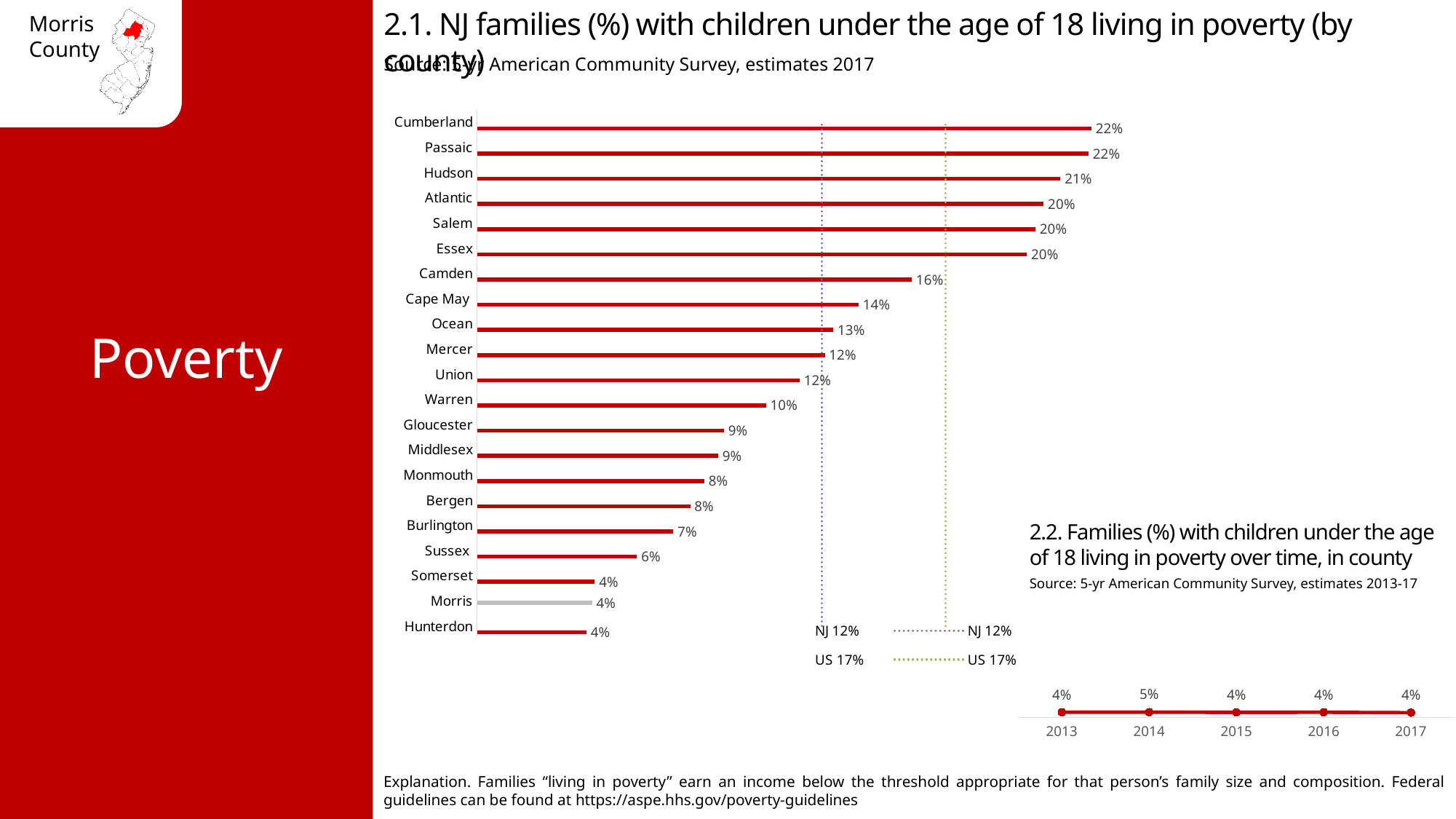
What kind of chart is chart 2.2 (over time, in county)? Line chart In chart 2.1 (by county), what value is shown for the US reference line? 17% In chart 2.1 (by county), what is the value for Morris? 4% In chart 2.2 (families in poverty over time, in county), what is the value for 2014? 5% In chart 2.1 (by county), what is the difference between the values for Camden and Morris? 12 percentage points In chart 2.2 (over time, in county), how many years are plotted? 5 In chart 2.1 (by county), how many counties are plotted? 21 In chart 2.1 (NJ families with children under 18 living in poverty by county), what is the value for Camden? 16% What kind of chart is chart 2.1 (by county)? Bar chart In chart 2.1 (by county), what is the value for Hudson? 21% In chart 2.2 (over time, in county), which year has the highest value? 2014 In chart 2.1 (by county), which has the larger value, Camden or Cape May? Camden